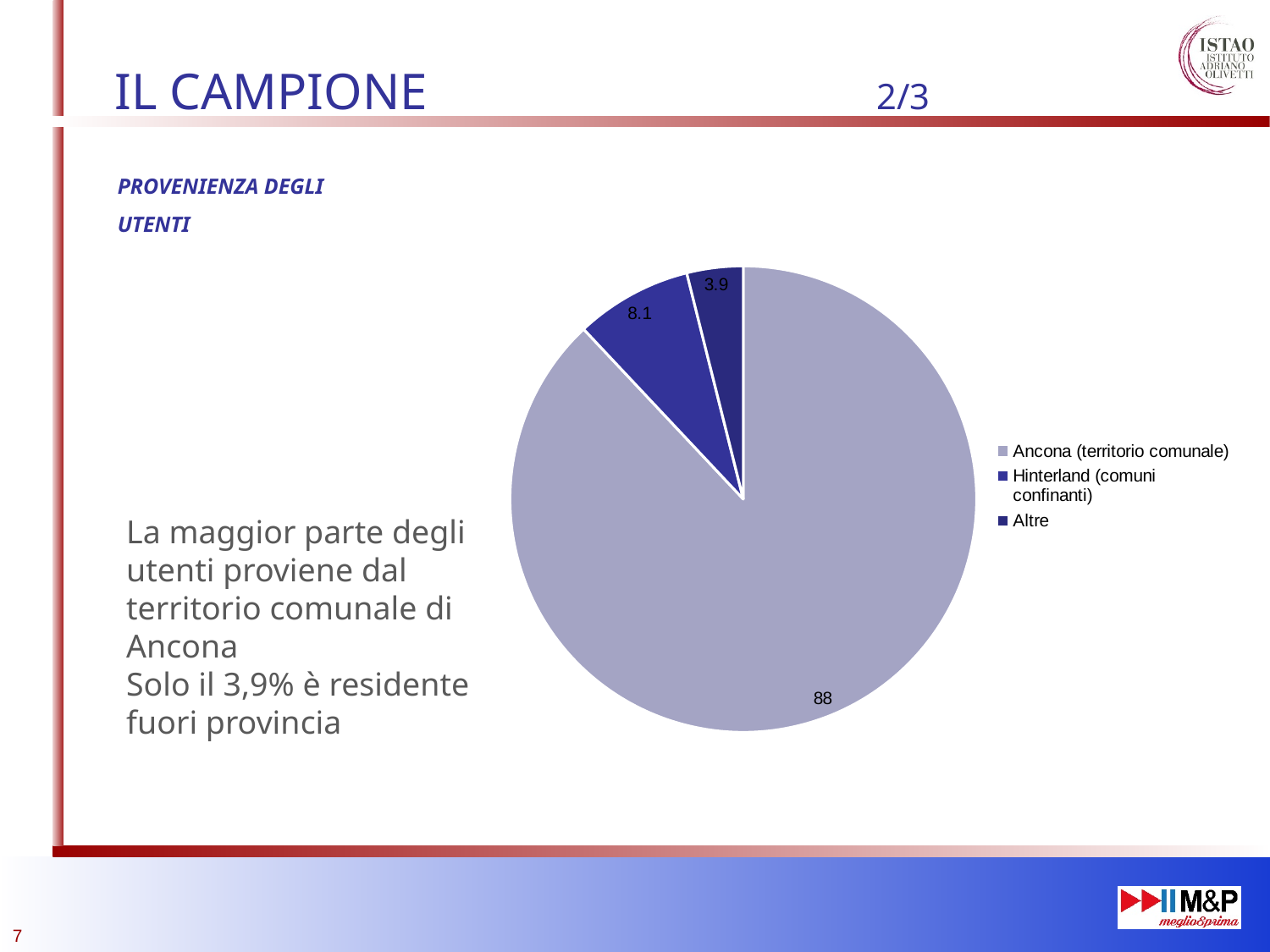
What is the value shown for Ancona (territorio comunale)? 88 How many slices does the pie chart have? 3 Which category has the smallest slice of the pie? Altre Which is larger, the value for Hinterland (comuni confinanti) or the value for Altre? Hinterland (comuni confinanti) What is the value shown for Hinterland (comuni confinanti)? 8.1 What is the difference between the values for Ancona (territorio comunale) and Hinterland (comuni confinanti)? 79.9 What kind of chart is shown on the slide? Pie chart What is the value shown for the Altre slice? 3.9 How many entries does the legend list? 3 Which category has the largest slice of the pie? Ancona (territorio comunale) What is the heading printed above the pie chart? PROVENIENZA DEGLI UTENTI What is the difference between the values for Hinterland (comuni confinanti) and Altre? 4.2